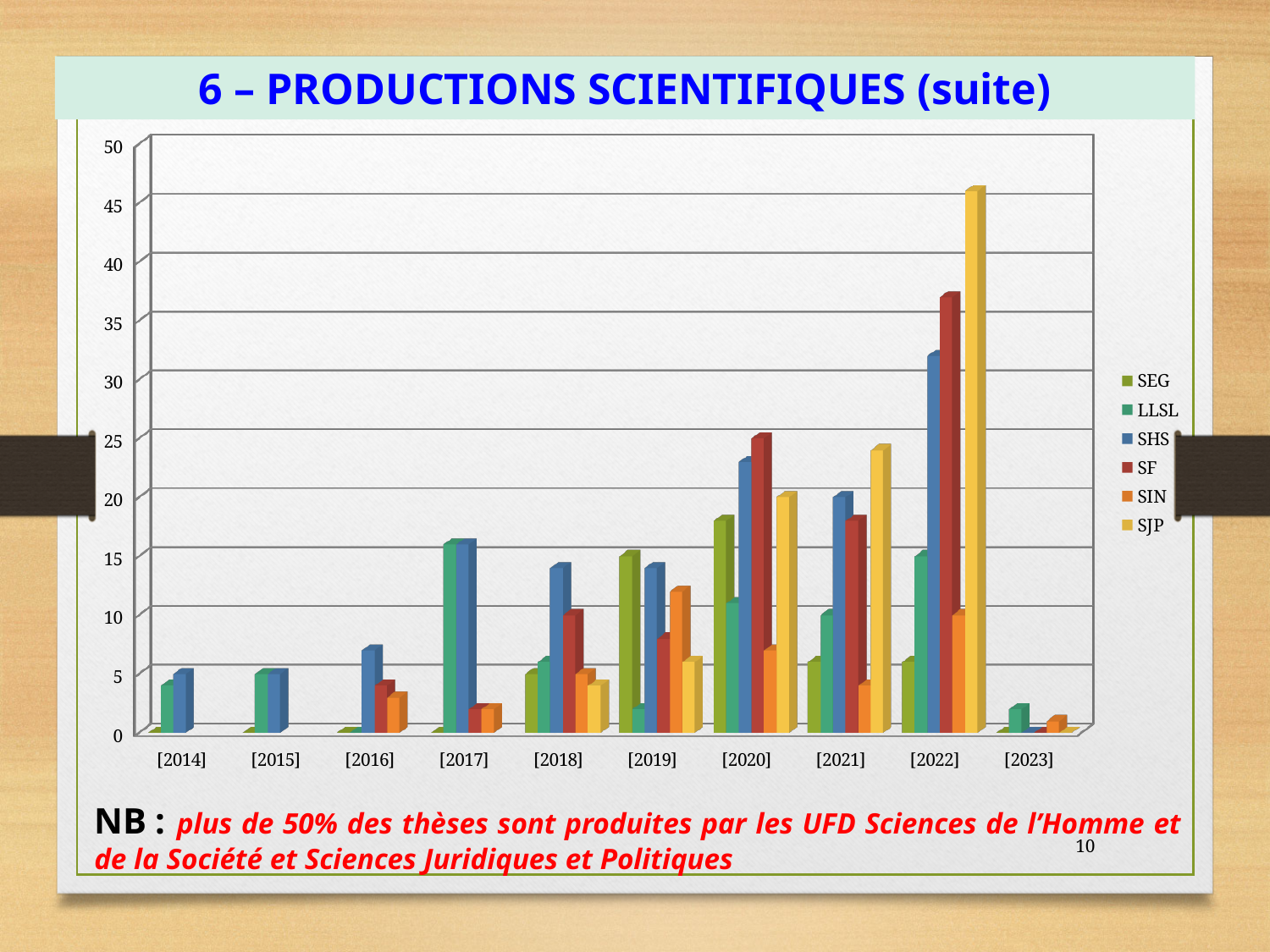
Is the value for SJP in [2022] greater or less than 40? greater How many year categories are shown on the x axis? 10 Is the value for SIN in [2019] greater or less than 10? greater Which series has the highest bar in [2021]? SJP In [2018], which is larger, the value for SHS or the value for SF? SHS How many series does the legend list? 6 In which year does the tallest bar of the chart appear? [2022] Is the value for LLSL in [2023] greater or less than 5? less Do the values for SJP rise or fall from [2018] to [2022]? rise Which series has the highest bar in [2022]? SJP What kind of chart is shown on the slide? bar chart